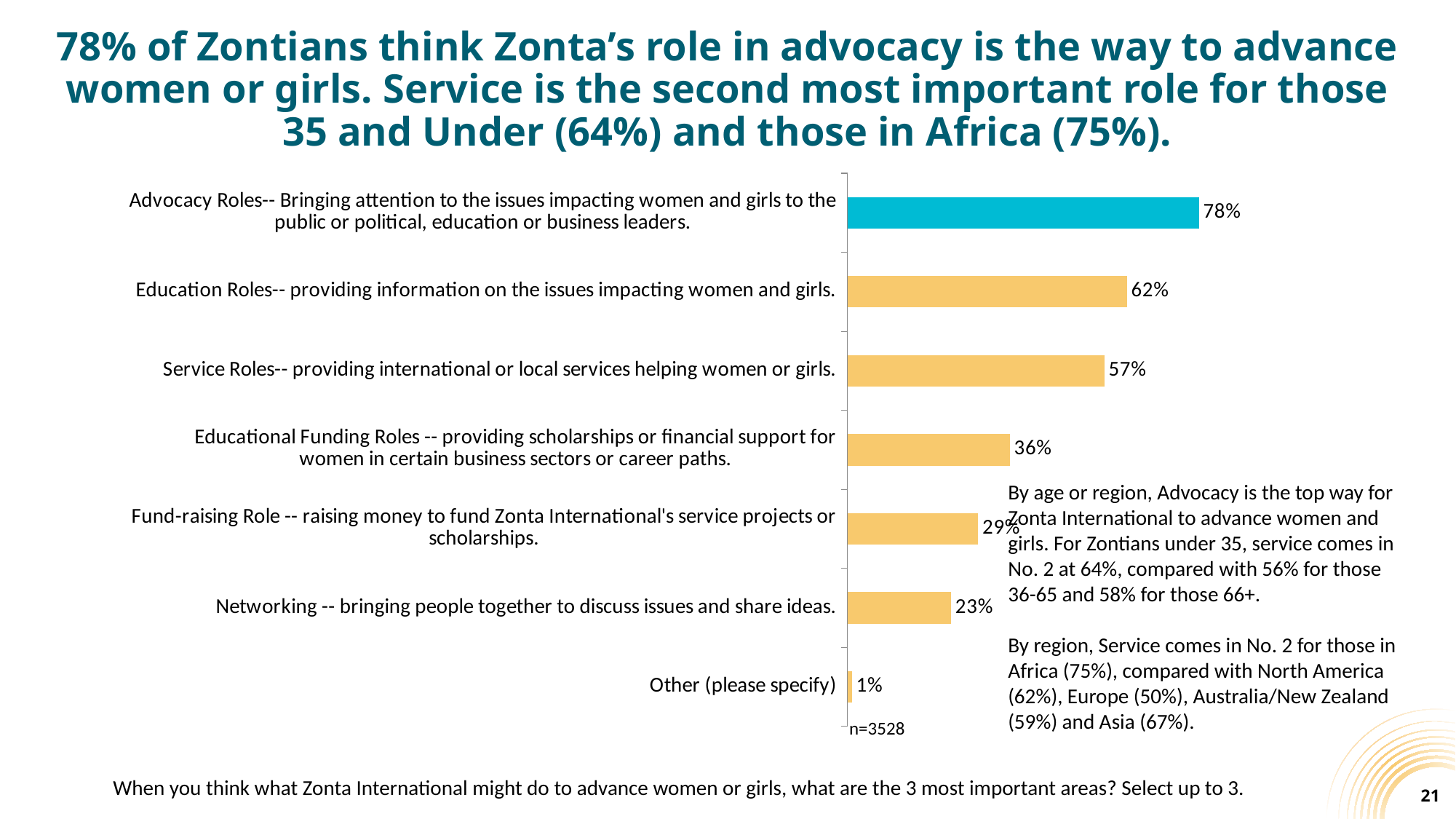
What type of chart is shown on the slide? Bar chart What is the value for Networking? 23% What is the difference between the values for Advocacy Roles and Education Roles? 16% What is the difference between the values for Educational Funding Roles and Fund-raising Role? 7% Which category has the highest value in the chart? Advocacy Roles What percentage of respondents selected Advocacy Roles? 78% Which has a larger value, Service Roles or Educational Funding Roles? Service Roles What is the value shown for Education Roles? 62% What percentage is shown for Service Roles? 57% What sample size (n) is noted below the chart? n=3528 Which category has the lowest value in the chart? Other (please specify) How many categories are shown in the chart? 7